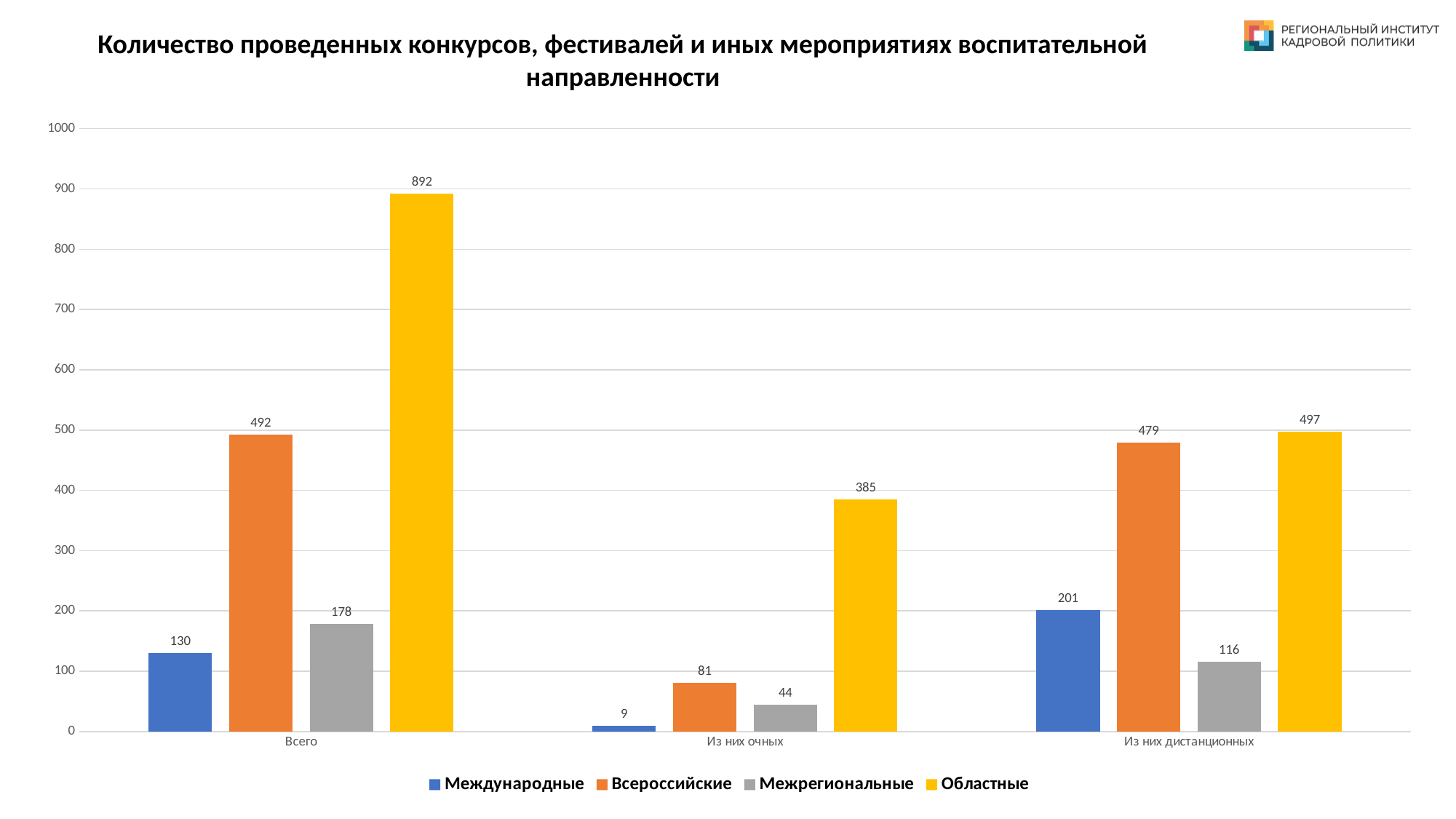
Which is larger: Межрегиональные in Всего or Межрегиональные in Из них дистанционных? Межрегиональные in Всего What is the value for Областные in the Всего category? 892 What colour are the bars for the Областные series? Yellow How many categories are shown on the x axis? 3 What is the value for Всероссийские in the Из них дистанционных category? 479 How many series does the legend list? 4 What is the difference between Международные in Из них дистанционных and Международные in Из них очных? 192 What is the difference between Областные and Всероссийские in the Всего category? 400 What is the value for Международные in the Из них очных category? 9 Which series has the highest value in the Всего category? Областные What kind of chart is shown on the slide? Bar chart Which series has the lowest value in the Из них очных category? Международные